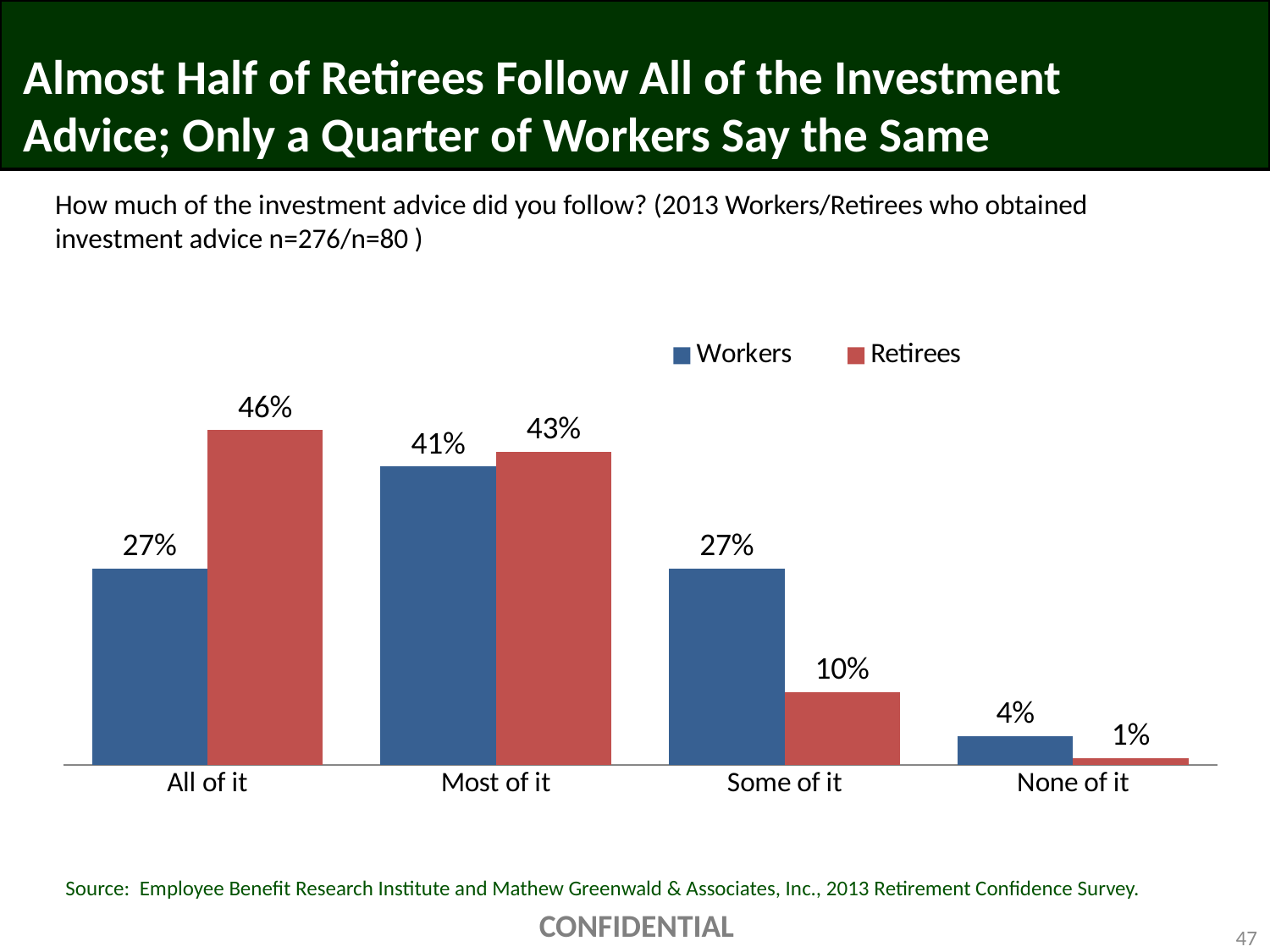
For 'Most of it', which series has the larger value, Workers or Retirees? Retirees How many categories are shown on the x axis? 4 What is the difference between the Retirees and Workers values for 'All of it'? 19 percentage points Which category has the highest value for Workers? Most of it What is the value for Workers in the 'None of it' category? 4% Which category has the lowest value for Retirees? None of it What percentage of Retirees said they followed all of the investment advice? 46% What percentage of Workers said they followed all of the investment advice? 27% How many series does the legend list? 2 What is the difference between the Workers and Retirees values for 'Some of it'? 17 percentage points What kind of chart is shown on the slide? Bar chart What is the value for Retirees in the 'Some of it' category? 10%